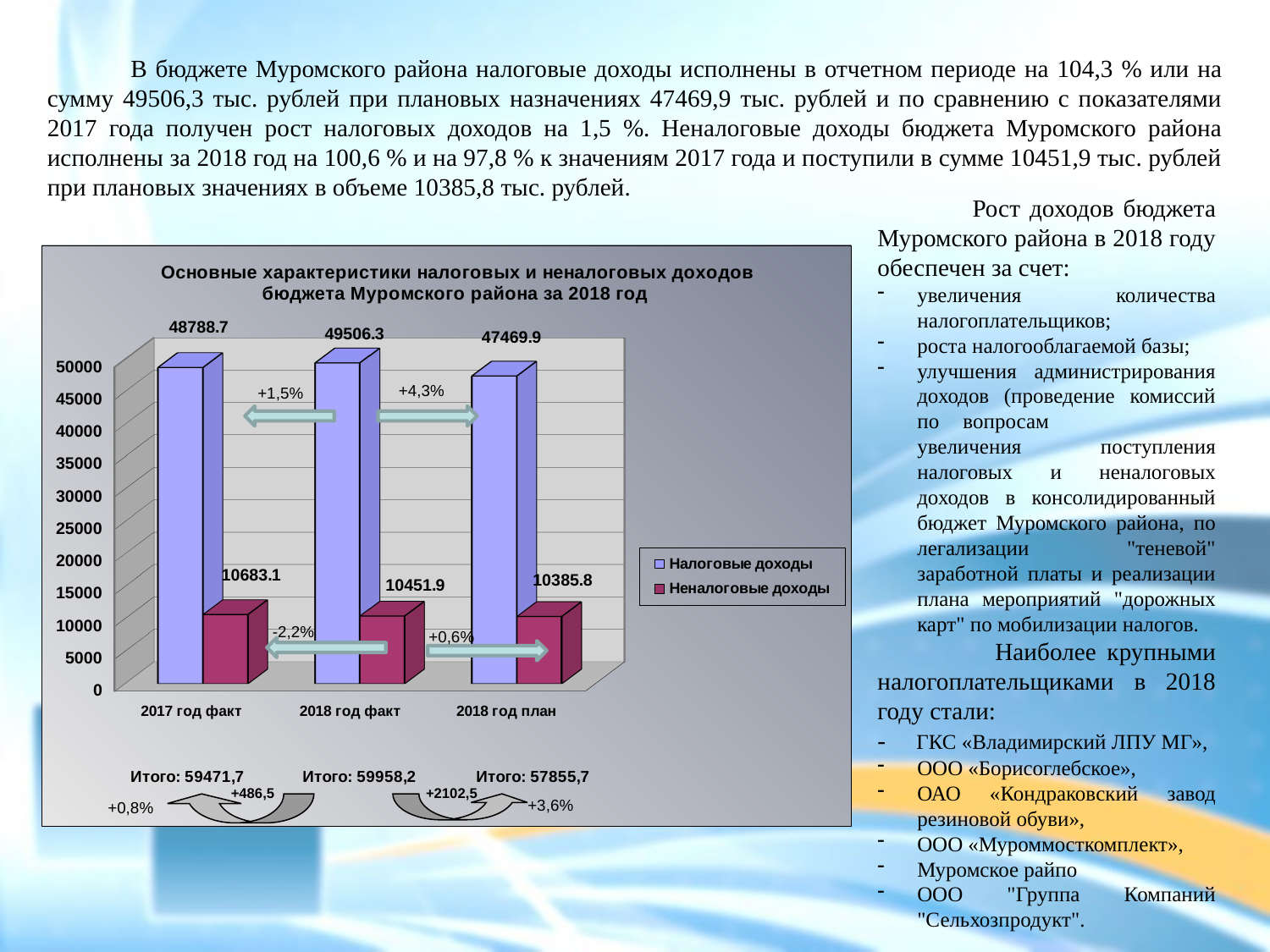
Which category has the lowest value for Неналоговые доходы? 2018 год план How many series does the legend list? 2 What is the value of Неналоговые доходы for 2018 год план? 10385.8 What is the value of Налоговые доходы for 2018 год факт? 49506.3 Which category has the highest value for Налоговые доходы? 2018 год факт How many categories are shown on the x axis? 3 What kind of chart is shown on the slide? Bar chart Which series is shown in blue in the legend? Налоговые доходы What is the value of Неналоговые доходы for 2017 год факт? 10683.1 What is the difference between Налоговые доходы for 2018 год факт and 2018 год план? 2036.4 Which is larger: Неналоговые доходы for 2017 год факт or for 2018 год факт? 2017 год факт What is the value of Налоговые доходы for 2018 год план? 47469.9